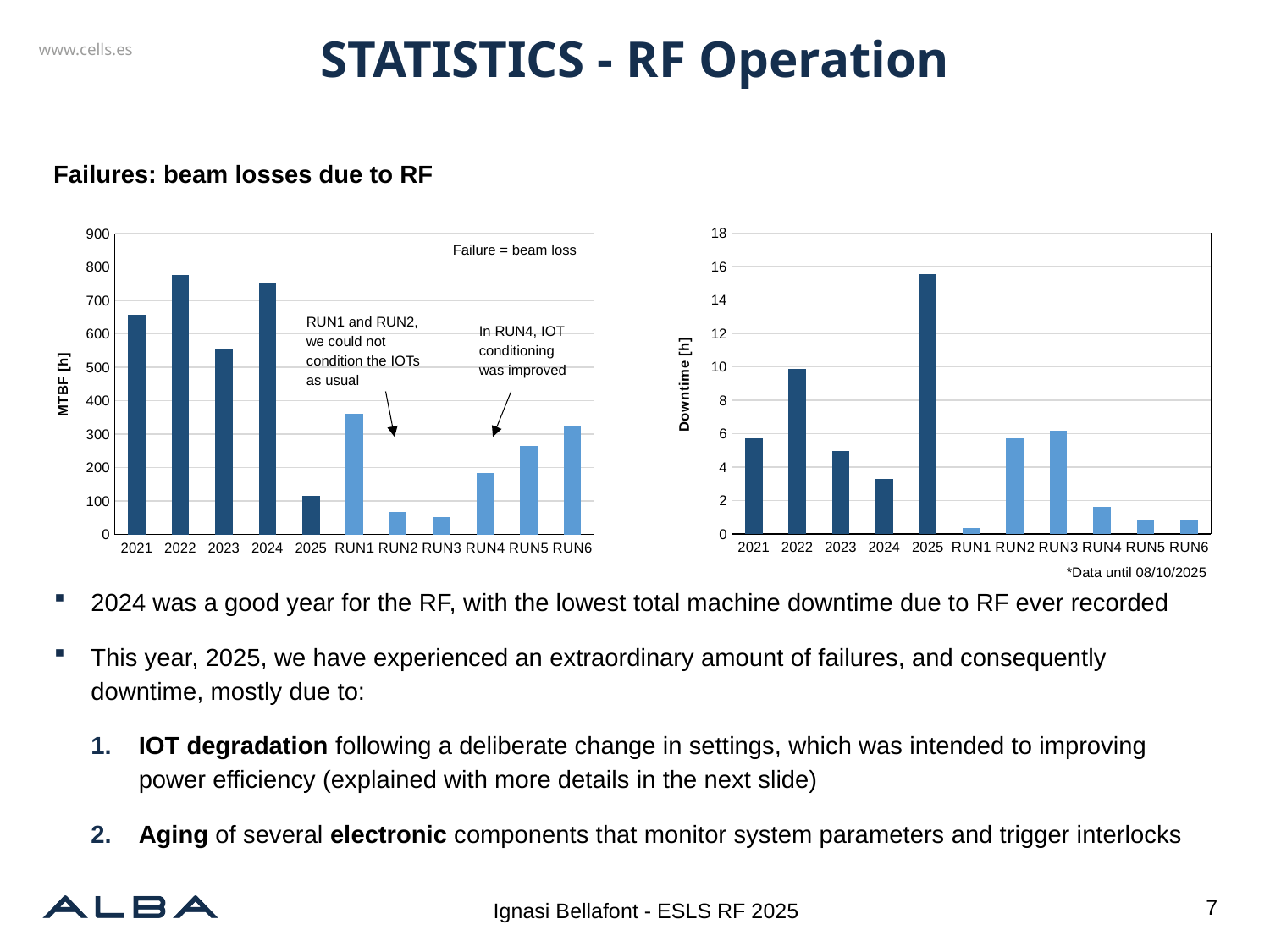
What is the y-axis title of the right chart? Downtime [h] In the right chart (Downtime [h]), is the value for 2024 greater or less than 4? less In the left chart (MTBF [h]), which is larger, the value for RUN1 or the value for RUN2? RUN1 In the right chart (Downtime [h]), which is larger, the value for 2022 or the value for 2023? 2022 How many categories are shown on the x axis of the right chart (Downtime [h])? 11 In the left chart (MTBF [h]), is the value for 2024 greater or less than 700? greater In the right chart (Downtime [h]), is the value for 2025 greater or less than 14? greater In the right chart (Downtime [h]), which category has the lowest value? RUN1 In the right chart (Downtime [h]), which category has the highest value? 2025 What kind of chart is the left chart (MTBF [h])? bar chart In the left chart (MTBF [h]), which category has the highest value? 2022